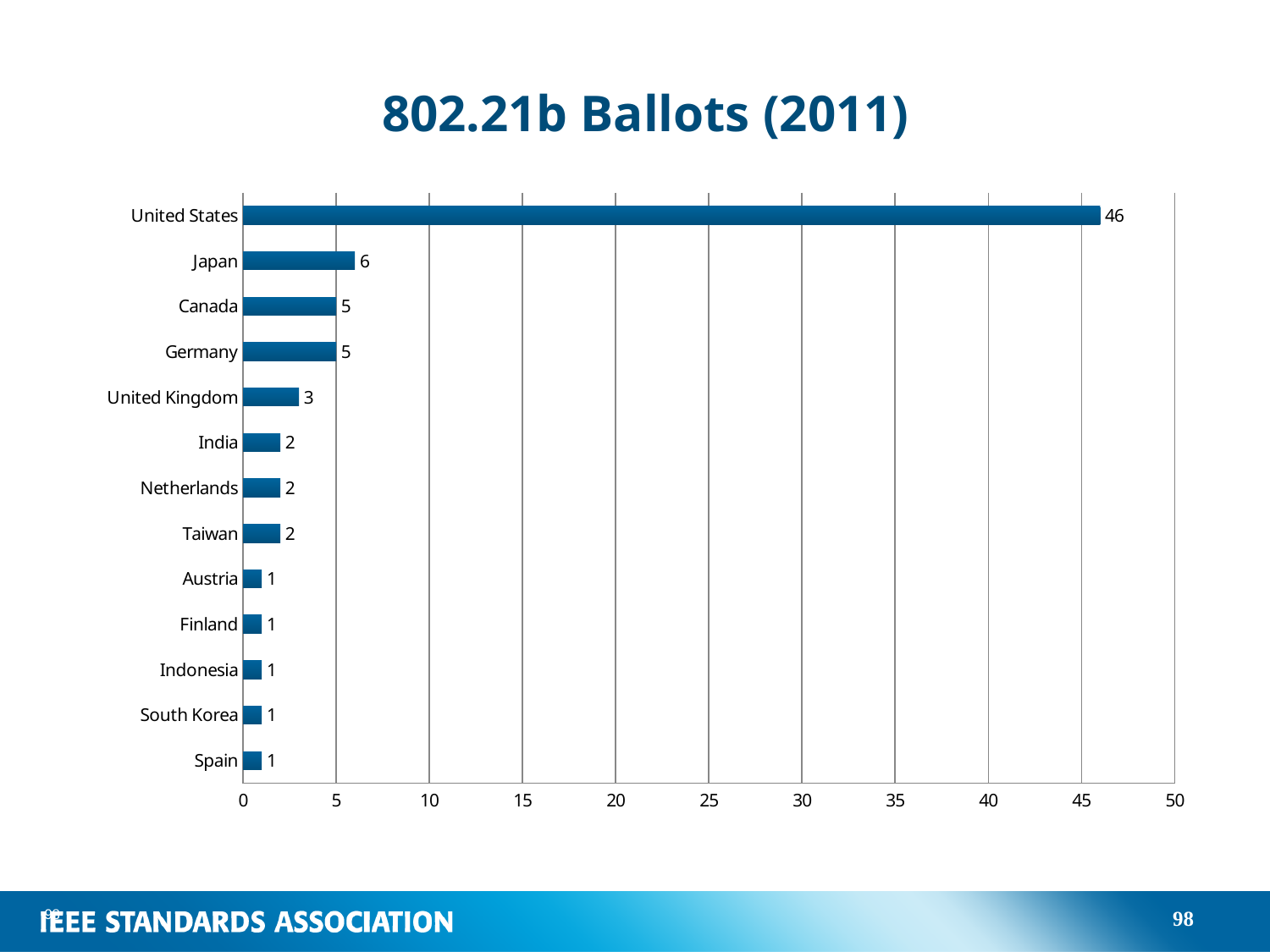
What is the difference between the values for United States and Japan? 40 What is the value for United Kingdom? 3 What is the value for Japan? 6 How many countries are shown in the chart? 13 Is the value for United States greater or less than 40? greater Which is larger, the value for Germany or the value for Taiwan? Germany What is the title of the chart? 802.21b Ballots (2011) What kind of chart is shown on the slide? bar chart Which country has the highest value? United States What is the difference between the values for Canada and India? 3 How many countries have a value of 1? 5 What is the value for United States? 46